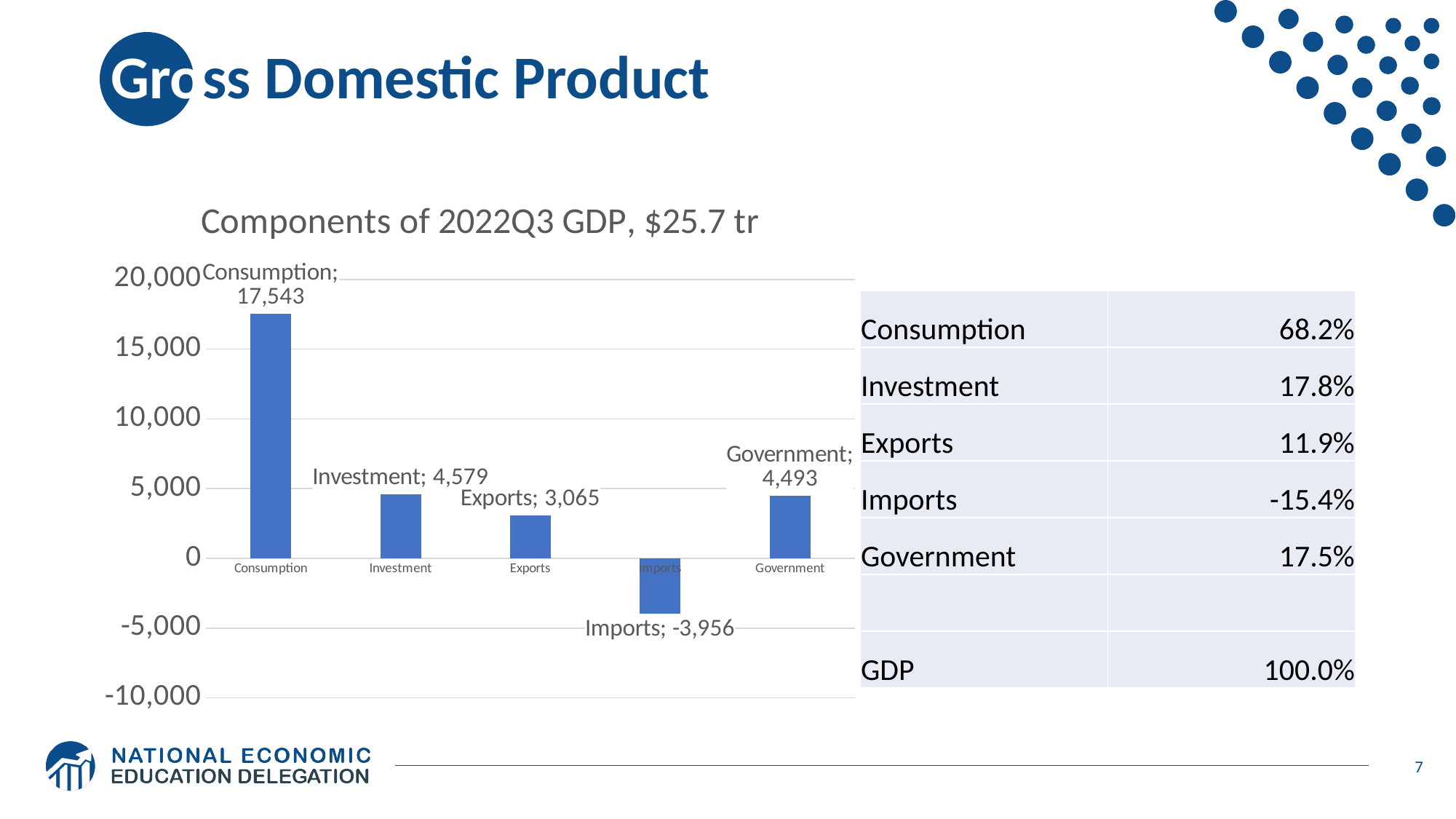
Which is larger, the value for Investment or the value for Government? Investment Which category has the lowest value in the chart? Imports What is the title of the chart? Components of 2022Q3 GDP, $25.7 tr What is the difference between the values for Investment and Exports? 1,514 How many categories are shown on the x axis of the chart? 5 What is the value for Imports in the chart? -3,956 What kind of chart is shown on the slide? bar chart What is the difference between the values for Consumption and Government? 13,050 What is the value for Consumption in the chart? 17,543 What is the value for Government in the chart? 4,493 Is the value for Exports greater or less than 5,000? less Which category has the highest value in the chart? Consumption